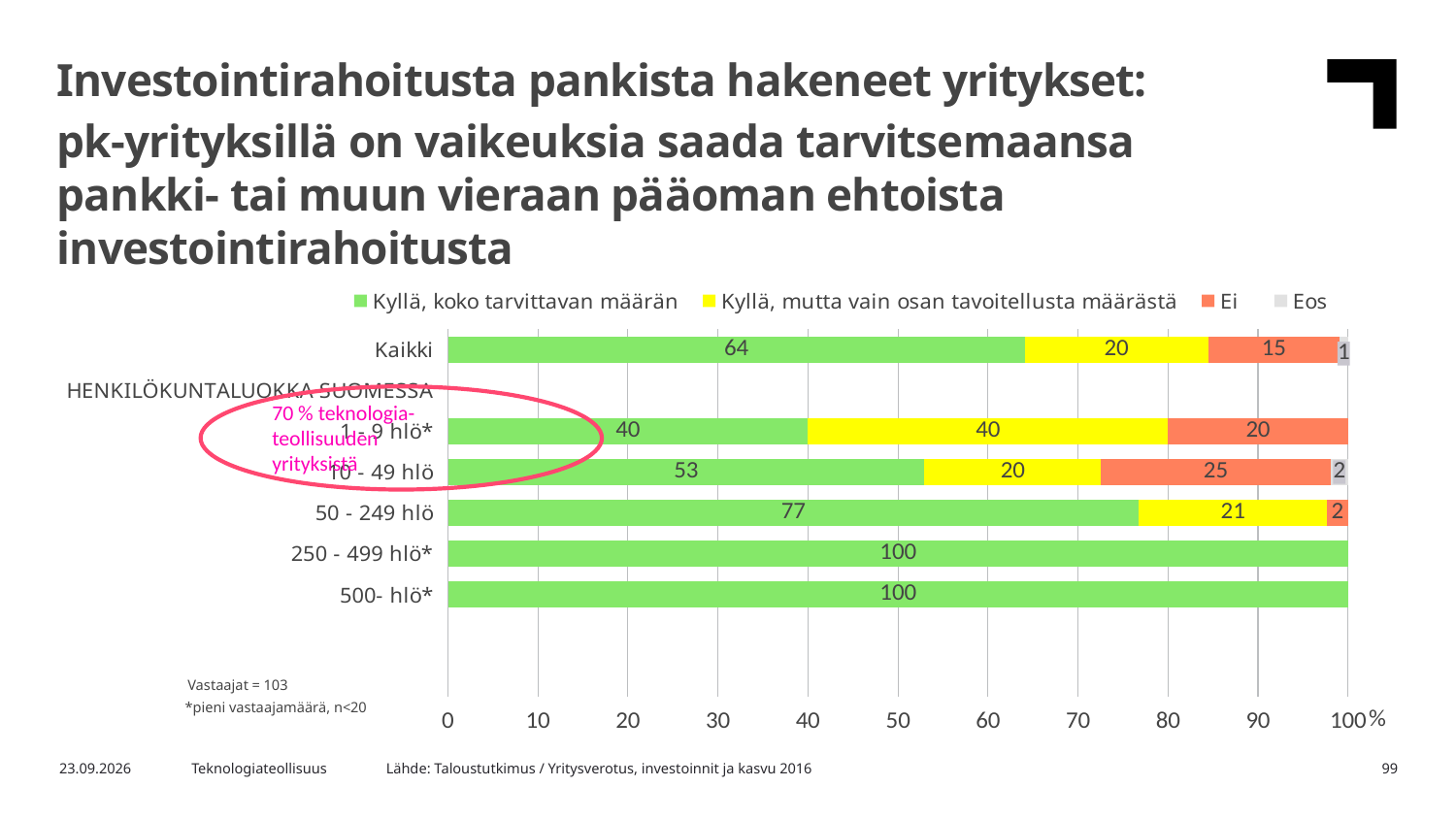
What is the value of "Kyllä, koko tarvittavan määrän" for 50 - 249 hlö? 77 Which colour represents the "Ei" series in the chart? orange How many series does the legend list? 4 What is the value of "Kyllä, koko tarvittavan määrän" for Kaikki? 64 Which is larger: the "Ei" value for 10 - 49 hlö or for Kaikki? 10 - 49 hlö What is the value of "Ei" for 10 - 49 hlö? 25 What kind of chart is shown on the slide? stacked bar chart What is the difference between the "Kyllä, koko tarvittavan määrän" values for 50 - 249 hlö and 10 - 49 hlö? 24 Which category has the lowest value for "Kyllä, koko tarvittavan määrän"? 1 - 9 hlö* What is the value of "Kyllä, mutta vain osan tavoitellusta määrästä" for 1 - 9 hlö*? 40 What is the value of "Eos" for Kaikki? 1 How many categories are shown on the vertical axis of the chart? 6